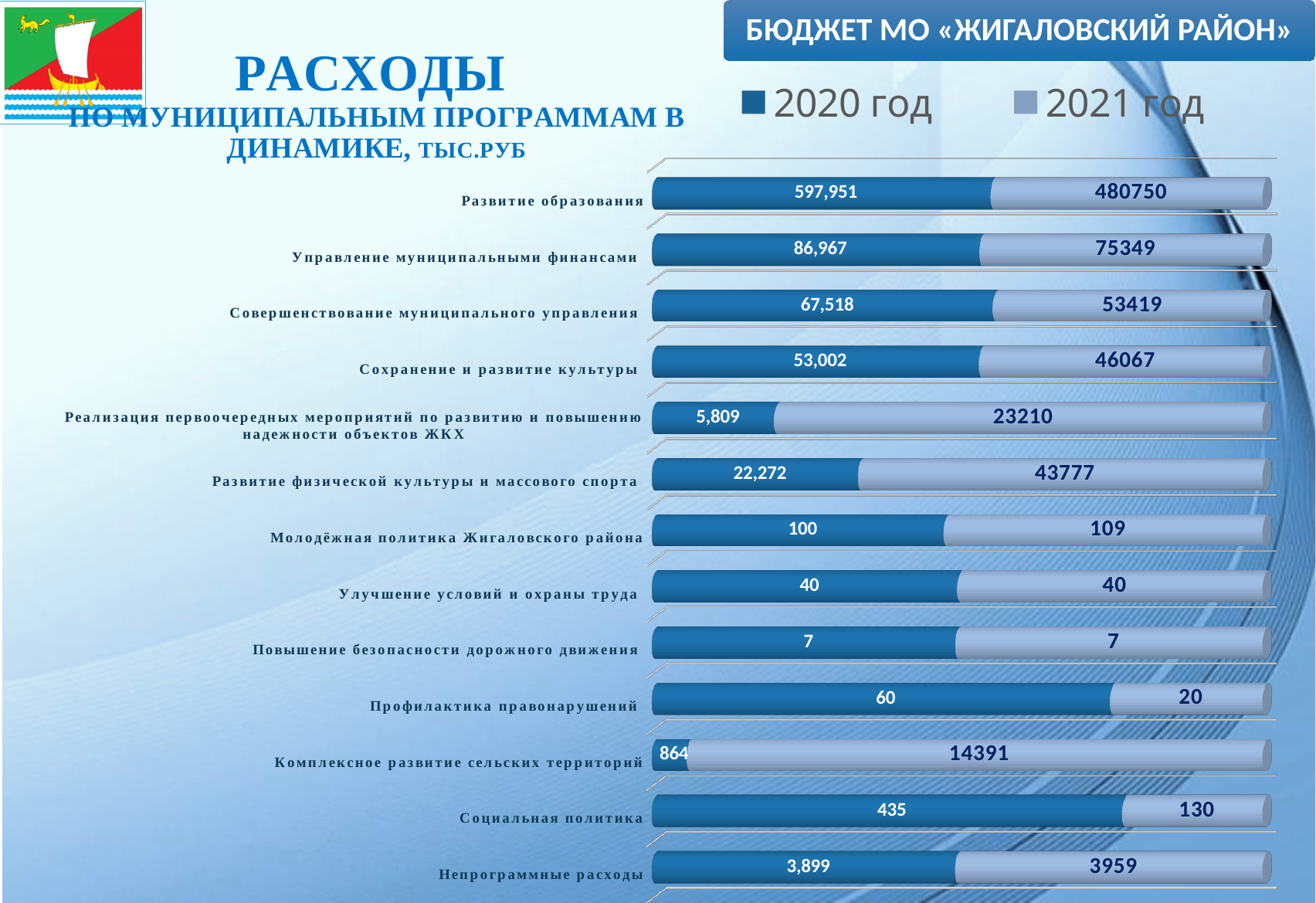
How many series does the legend list? 2 Which category has the highest 2020 год value? Развитие образования For Развитие физической культуры и массового спорта, which year has the larger value, 2020 год or 2021 год? 2021 год Which category has the lowest 2021 год value? Повышение безопасности дорожного движения What is the 2021 год value for Комплексное развитие сельских территорий? 14391 What is the difference between the 2020 год and 2021 год values for Профилактика правонарушений? 40 What is the 2021 год value for Непрограммные расходы? 3959 What is the 2020 год value for Реализация первоочередных мероприятий по развитию и повышению надежности объектов ЖКХ? 5,809 What is the difference between the 2020 год and 2021 год values for Социальная политика? 305 What kind of chart is shown on the slide? Bar chart How many categories are shown in the chart? 13 What is the 2020 год value for Развитие образования? 597,951